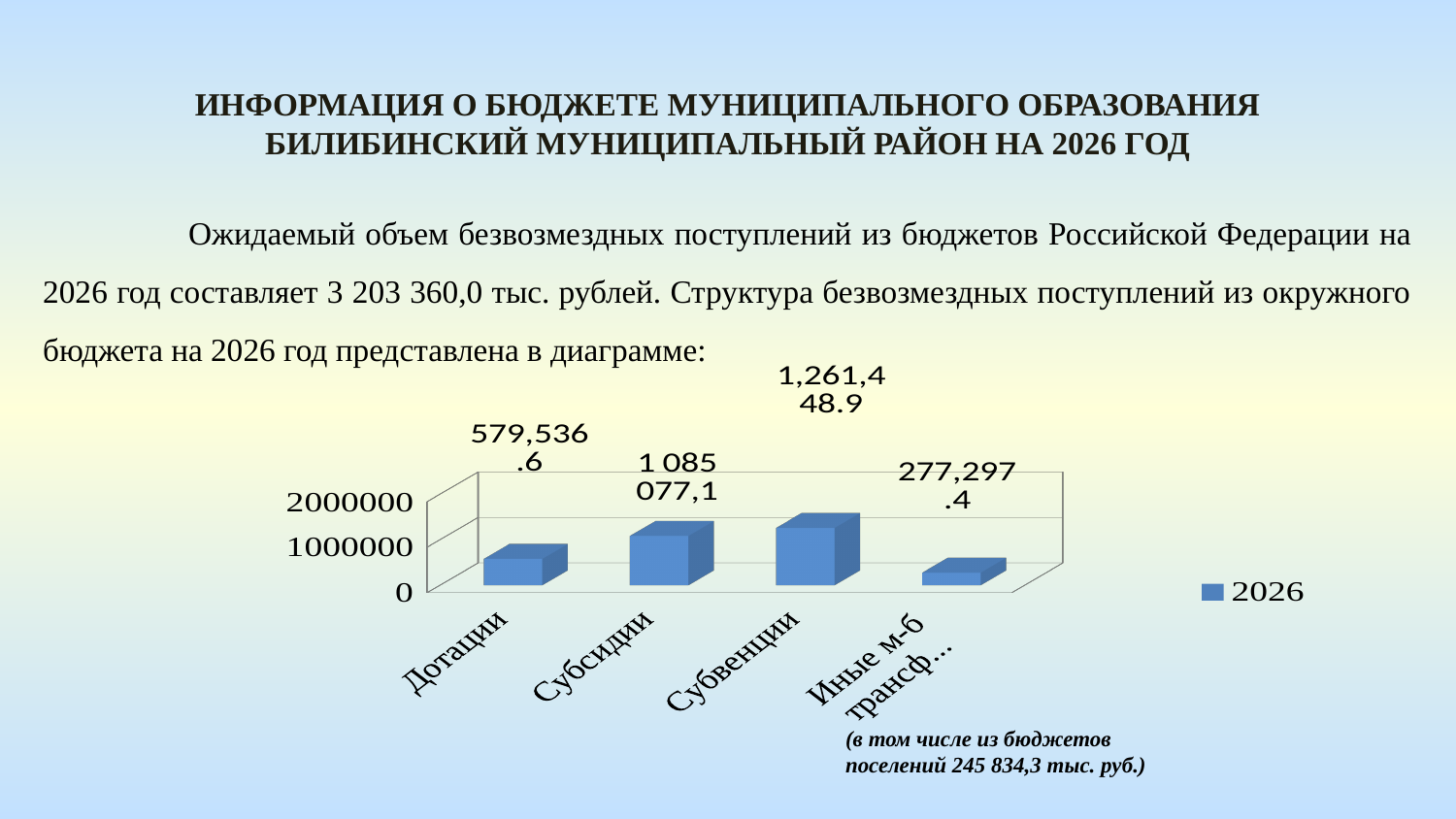
What is the value shown for the rightmost bar (Иные м-б трансф...)? 277,297.4 What is the value shown for Субсидии? 1 085 077,1 Which category has the highest value? Субвенции What is the value shown for Субвенции? 1,261,448.9 Is the value for Дотации greater or less than 1000000? less What is the value shown for Дотации? 579,536.6 How many series does the chart legend list? 1 What entry is shown in the chart legend? 2026 How many categories are plotted on the chart? 4 Which category has the lowest value? Иные м-б трансф... What kind of chart is shown on the slide? bar chart Which is larger, the value for Субсидии or the value for Дотации? Субсидии